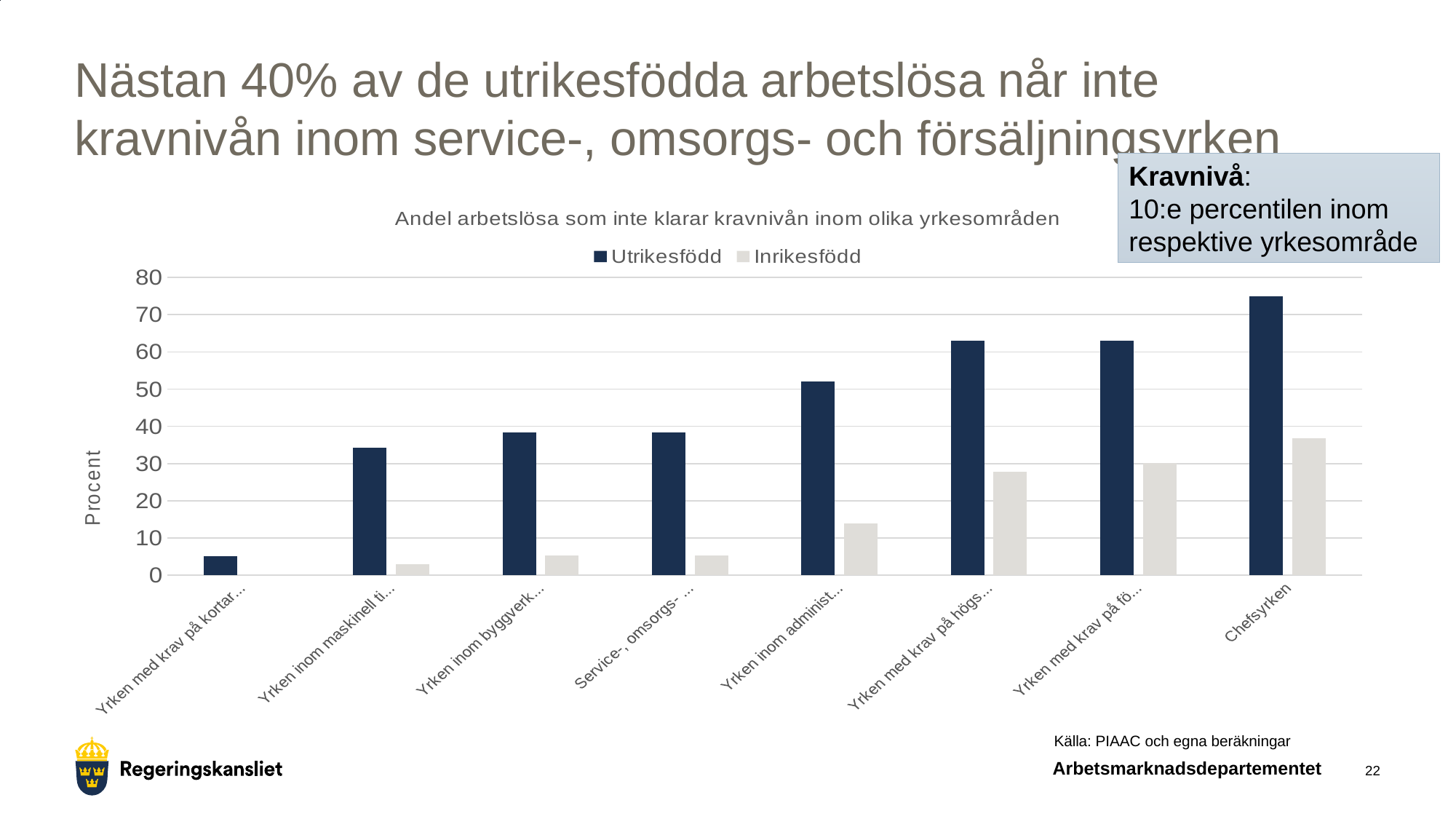
Which category has the highest Inrikesfödd value? Chefsyrken Is the Inrikesfödd value for Chefsyrken greater or less than 40? less For Chefsyrken, which series has the larger value, Utrikesfödd or Inrikesfödd? Utrikesfödd Which category has the highest Utrikesfödd value? Chefsyrken How many series does the legend list? 2 How many occupational categories are shown on the x axis? 8 What kind of chart is shown on the slide? bar chart Is the Utrikesfödd value for Chefsyrken greater or less than 70? greater Is the Inrikesfödd value for Chefsyrken greater or less than 30? greater Do the Utrikesfödd values generally rise or fall from left to right along the x axis? rise What is the title of the chart? Andel arbetslösa som inte klarar kravnivån inom olika yrkesområden What is the label on the y axis? Procent